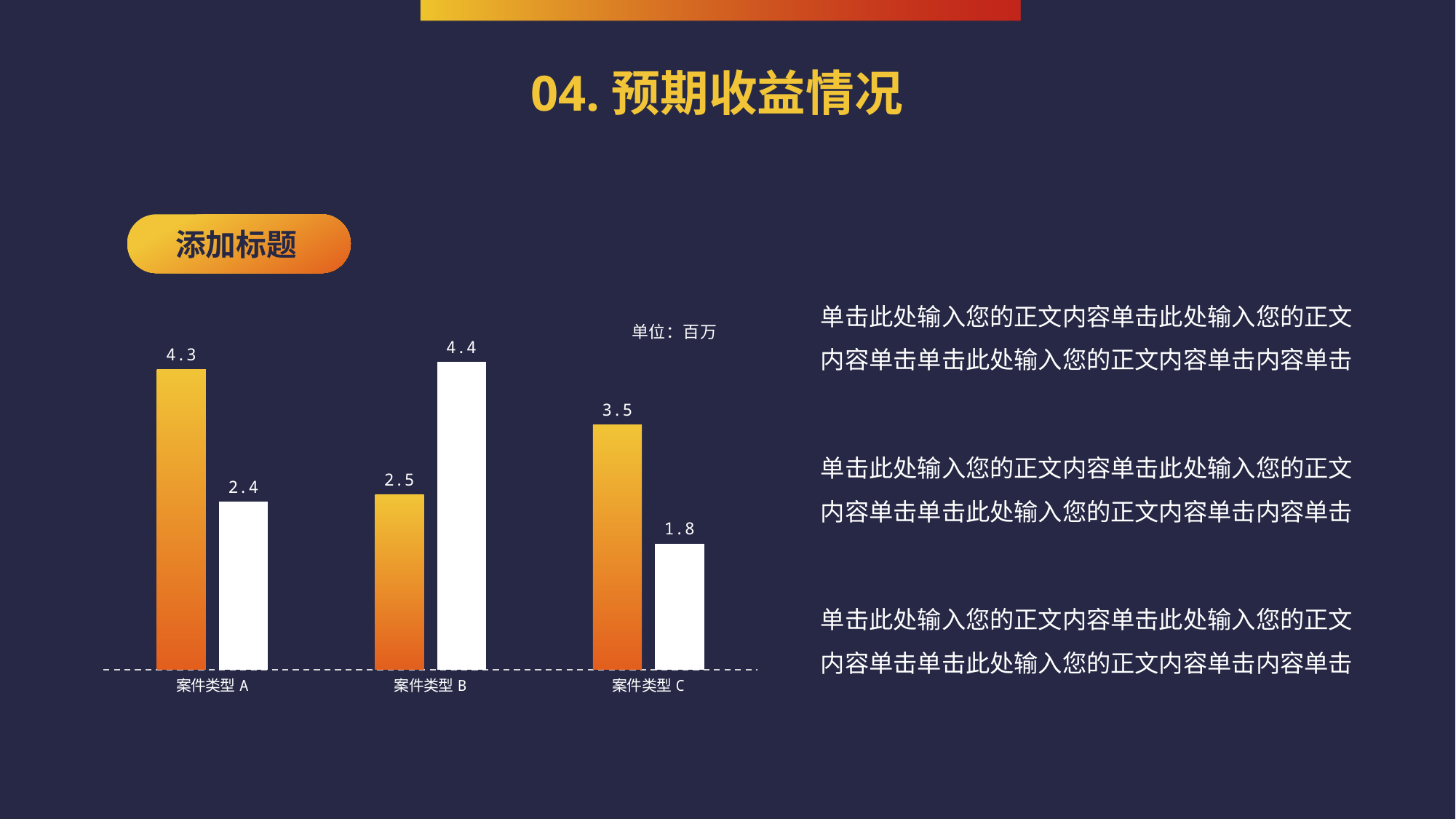
What is the value of the orange bar for 案件类型 C? 3.5 What is the value of the orange bar for 案件类型 A? 4.3 Which category has the highest orange bar? 案件类型 A What is the difference between the white bar and the orange bar for 案件类型 B? 1.9 What is the highest value shown on the chart? 4.4 What is the value of the white bar for 案件类型 C? 1.8 Which category has the lowest white bar? 案件类型 C What kind of chart is shown on the slide? bar chart What is the value of the white bar for 案件类型 B? 4.4 What is the difference between the orange bar and the white bar for 案件类型 A? 1.9 How many categories are shown on the x axis of the chart? 3 For 案件类型 C, which bar is larger, the orange one or the white one? the orange one